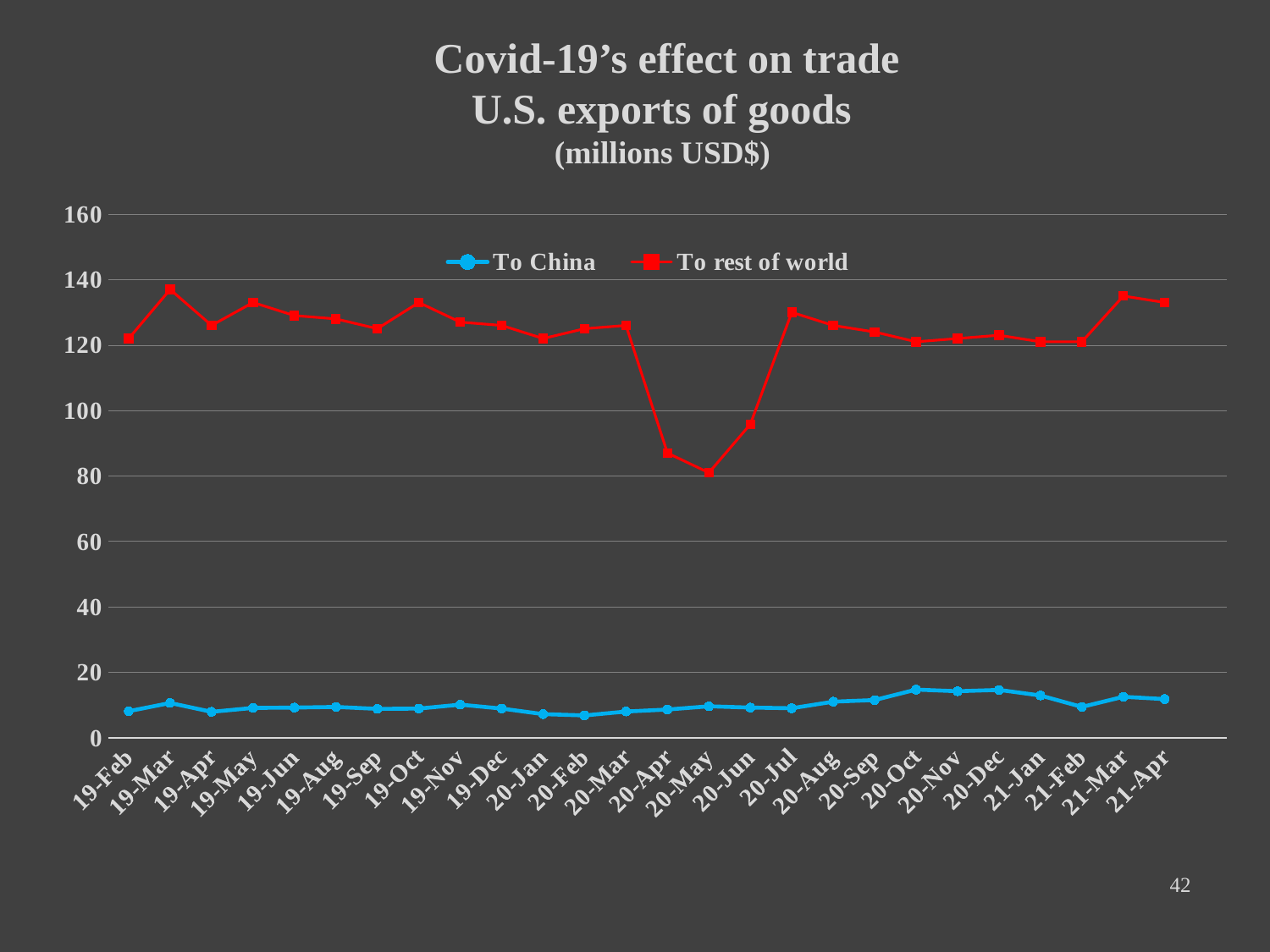
Which is larger in 20-Jul: the value for To China or the value for To rest of world? To rest of world Which colour is used for the To China series? blue Is the value for To rest of world in 20-May greater or less than 100? less Does the To rest of world line rise or fall from 20-Mar to 20-May? fall What kind of chart is shown on the slide? line chart Is the value for To rest of world in 20-Apr greater or less than 100? less How many series does the legend list? 2 Is the value for To rest of world in 19-Mar greater or less than 120? greater Which is larger for To rest of world: the value in 20-Jun or the value in 20-Jul? 20-Jul In which month is the value for To rest of world lowest? 20-May How many months are plotted along the x axis? 26